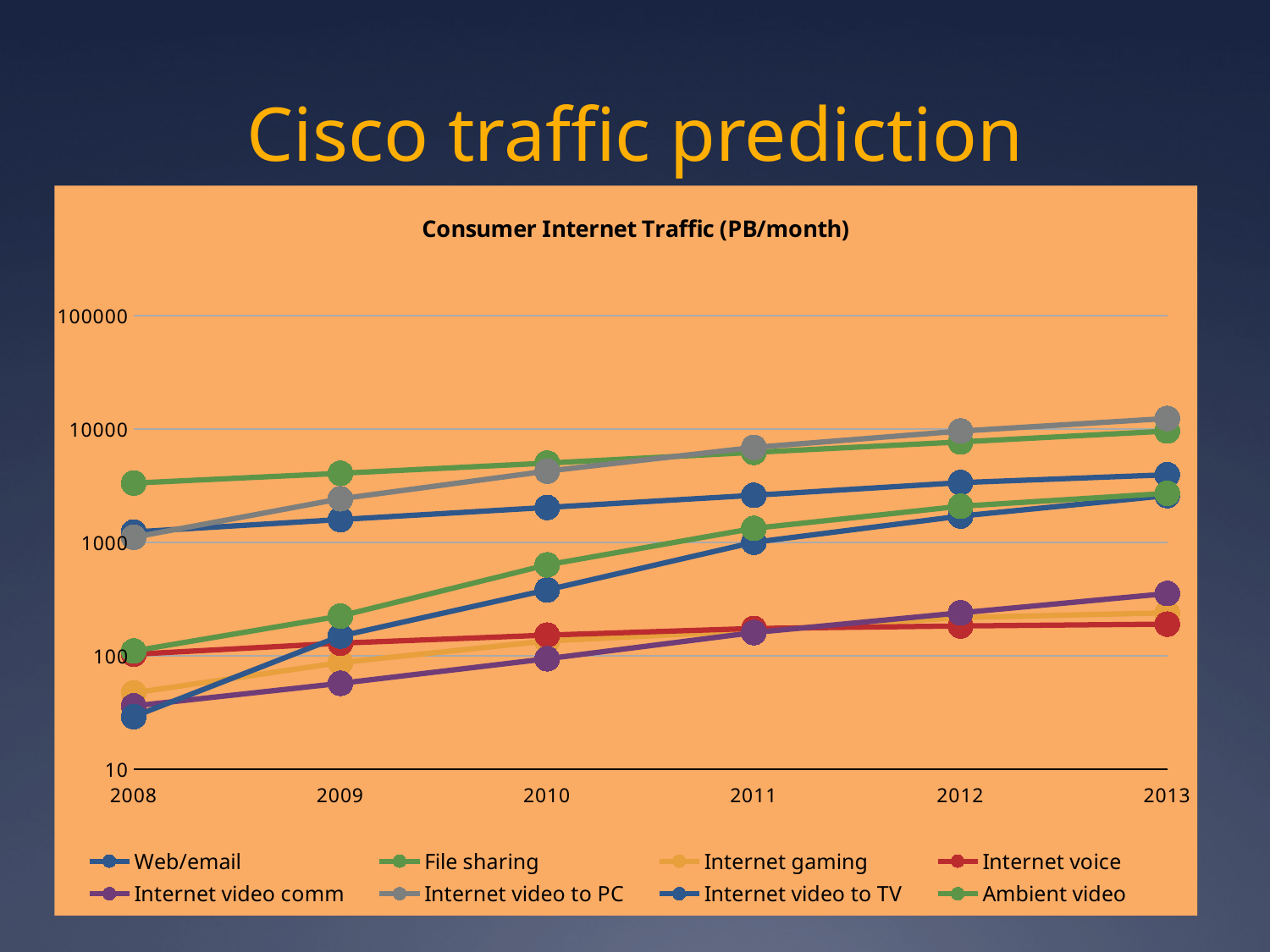
In 2012, which is larger: Internet video to PC or Internet voice? Internet video to PC In 2013, which is larger: Internet video comm or Internet gaming? Internet video comm Is the value for Internet video to PC in 2011 greater or less than 10000? less Which series has the highest value in 2013? Internet video to PC What kind of chart is shown on the slide? Line chart Does the Internet video comm series rise or fall from 2008 to 2013? Rises Is the value for Internet video comm in 2008 greater or less than 100? less Which series has the lowest value in 2013? Internet voice How many series does the legend list? 8 Is the value for Internet video to PC in 2013 greater or less than 10000? greater How many years are shown along the x axis? 6 What is the title of the chart? Consumer Internet Traffic (PB/month)